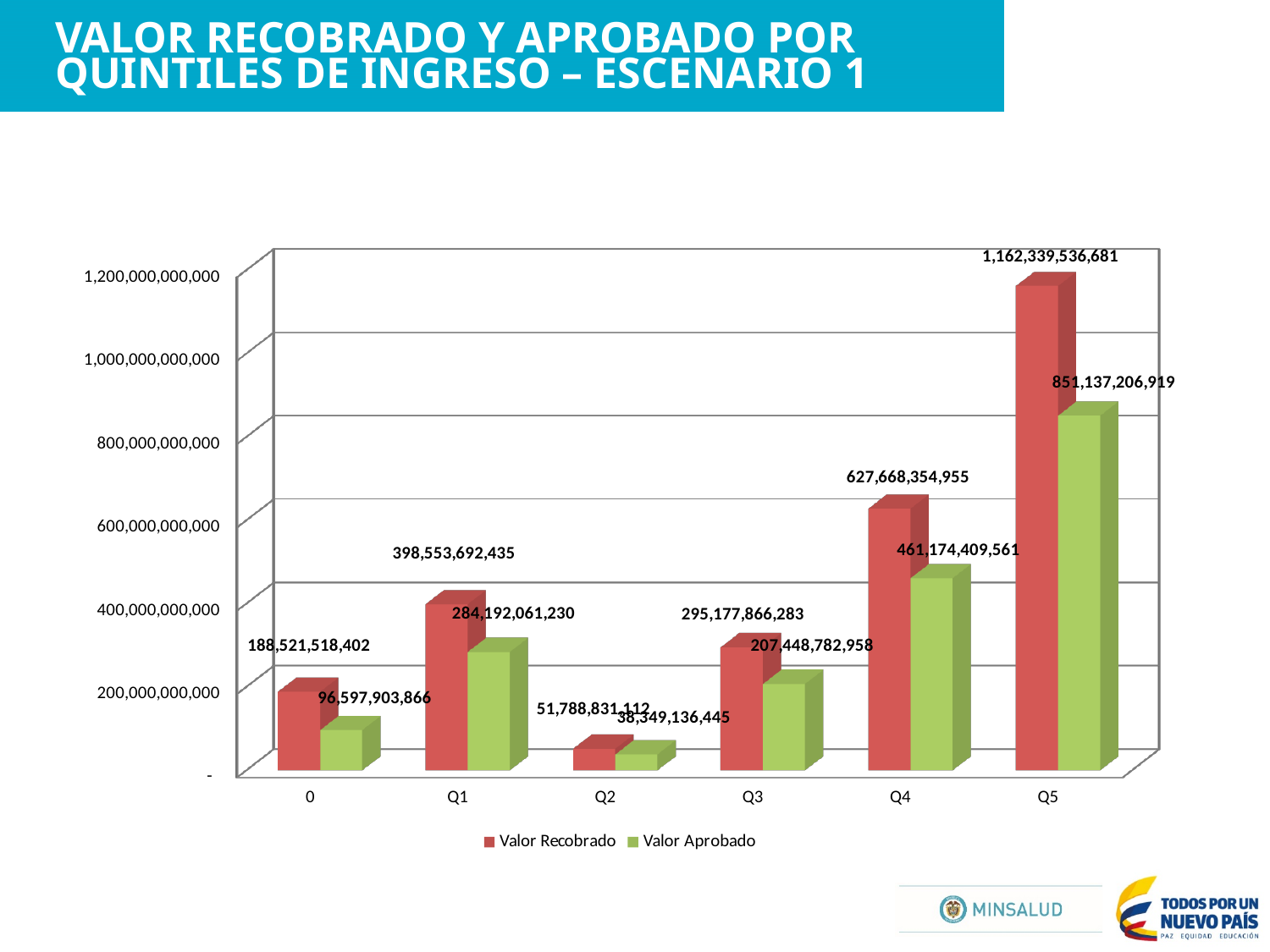
What is the Valor Aprobado for Q4? 461,174,409,561 Is the Valor Recobrado for Q4 greater or less than 600,000,000,000? greater What is the Valor Aprobado for Q3? 207,448,782,958 What is the Valor Recobrado for Q1? 398,553,692,435 What is the Valor Recobrado for Q5? 1,162,339,536,681 Which is larger for Q4, Valor Recobrado or Valor Aprobado? Valor Recobrado Which category has the highest Valor Recobrado? Q5 Which category has the lowest Valor Aprobado? Q2 How many categories are shown on the x axis? 6 What type of chart is shown on the slide? Bar chart What is the difference between Valor Recobrado and Valor Aprobado for Q5? 311,202,329,762 How many series does the legend list? 2